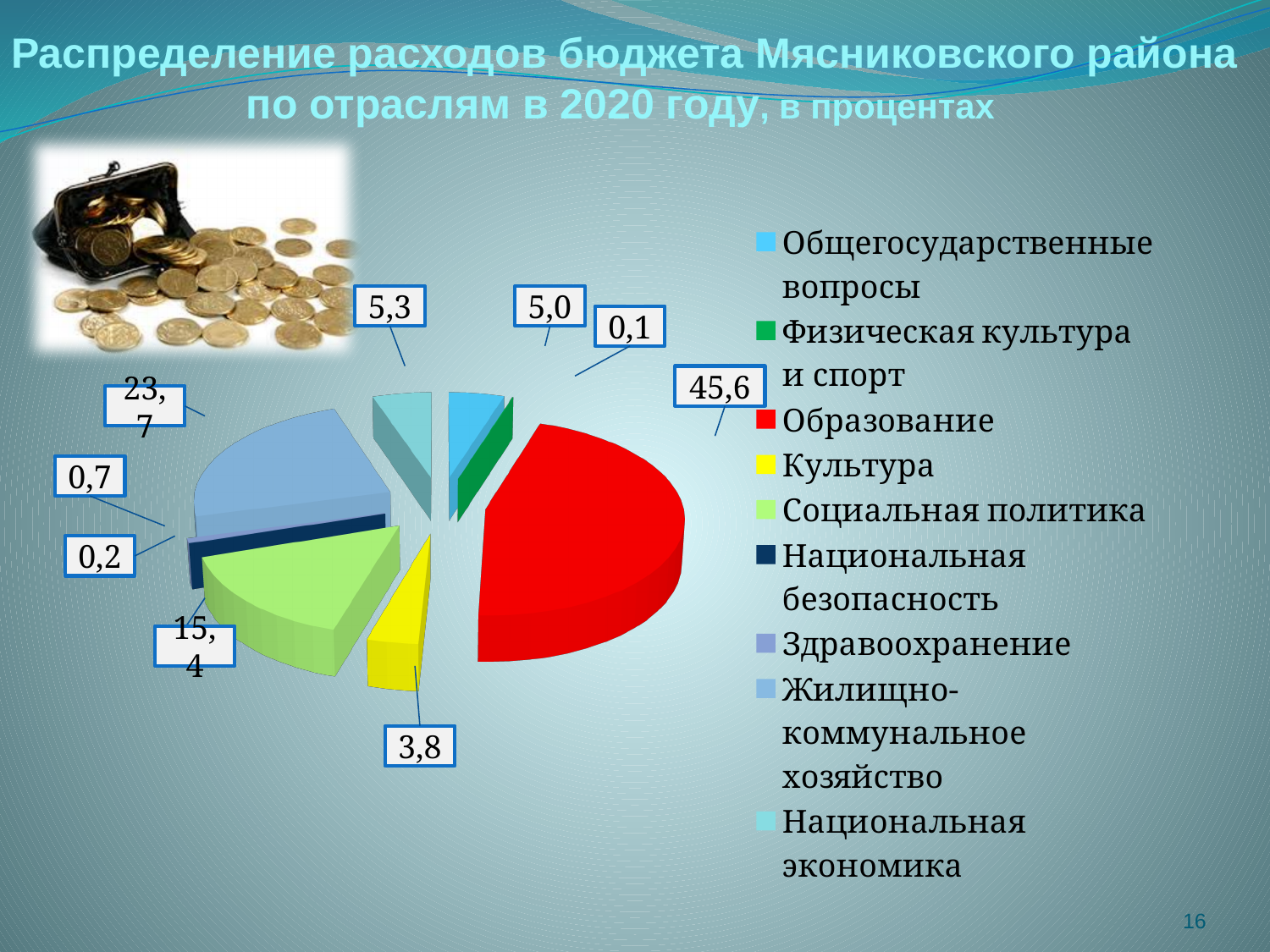
What value is shown for Культура? 3,8 How many sectors does the legend list? 9 What kind of chart is shown on the slide? pie chart Which is larger, the share for Социальная политика or the share for Национальная экономика? Социальная политика What is the difference between the shares of Образование and Жилищно-коммунальное хозяйство? 21,9 What value is shown for Жилищно-коммунальное хозяйство? 23,7 What colour is the slice for Образование? red What value is shown for Общегосударственные вопросы? 5,0 Which sector has the largest share of the budget expenditure? Образование Which sector has the smallest share of the budget expenditure? Физическая культура и спорт What value is shown for Социальная политика? 15,4 What percentage of the budget expenditure goes to Образование? 45,6